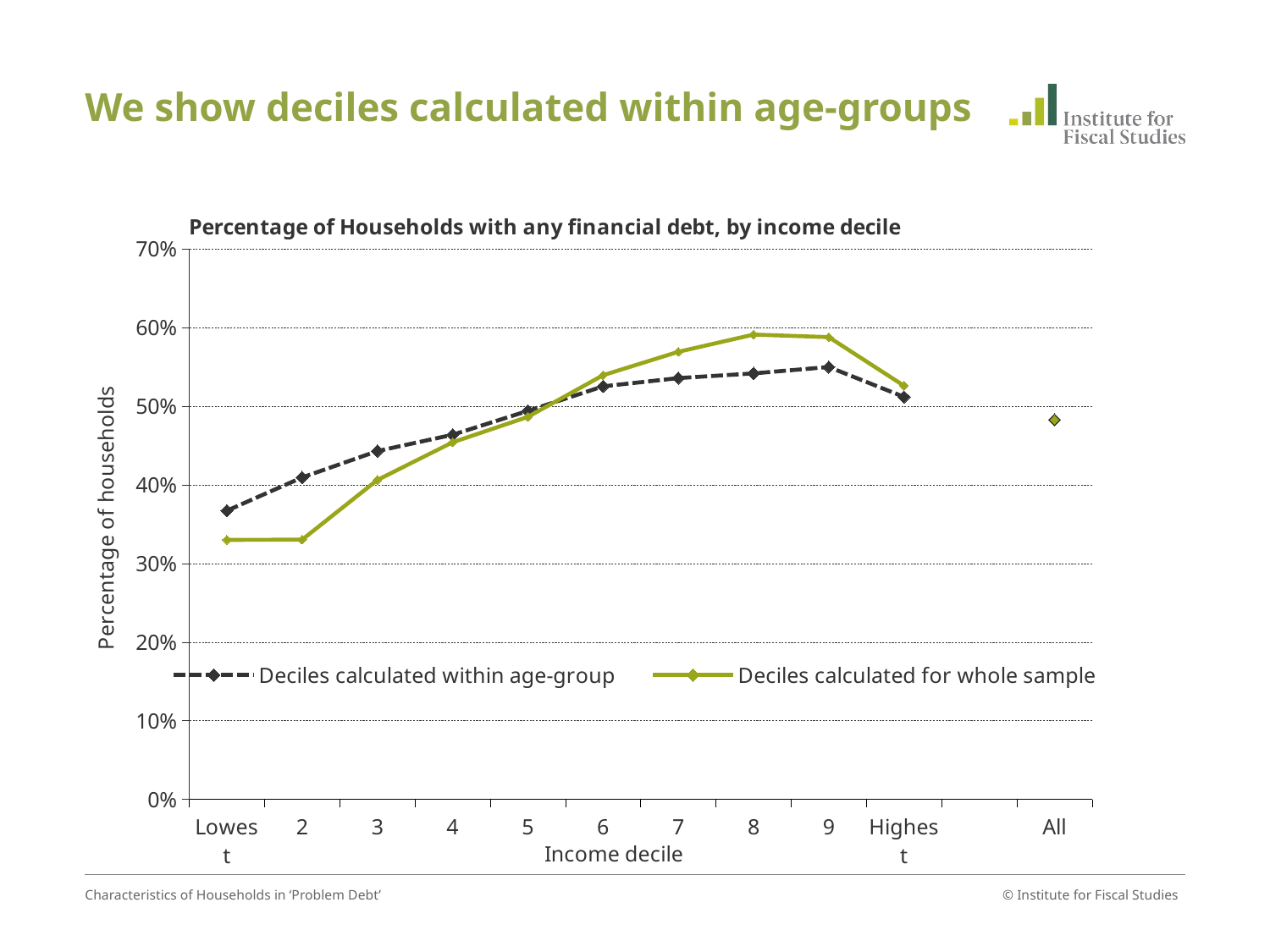
How many categories are shown along the x axis? 11 Is the value for the Lowest decile in the 'Deciles calculated within age-group' series greater or less than 40%? less Is the value for 'All' in the 'Deciles calculated for whole sample' series greater or less than 50%? less At the Lowest income decile, which series has the higher value? Deciles calculated within age-group Does the 'Deciles calculated for whole sample' series rise or fall from the Lowest decile to decile 8? Rise Which income decile has the lowest value for the 'Deciles calculated within age-group' series? Lowest Is the value for the Lowest decile in the 'Deciles calculated for whole sample' series greater or less than 30%? greater At income decile 8, which series has the higher value? Deciles calculated for whole sample What is the title of the chart? Percentage of Households with any financial debt, by income decile What kind of chart is shown on the slide? Line chart How many series does the legend list? 2